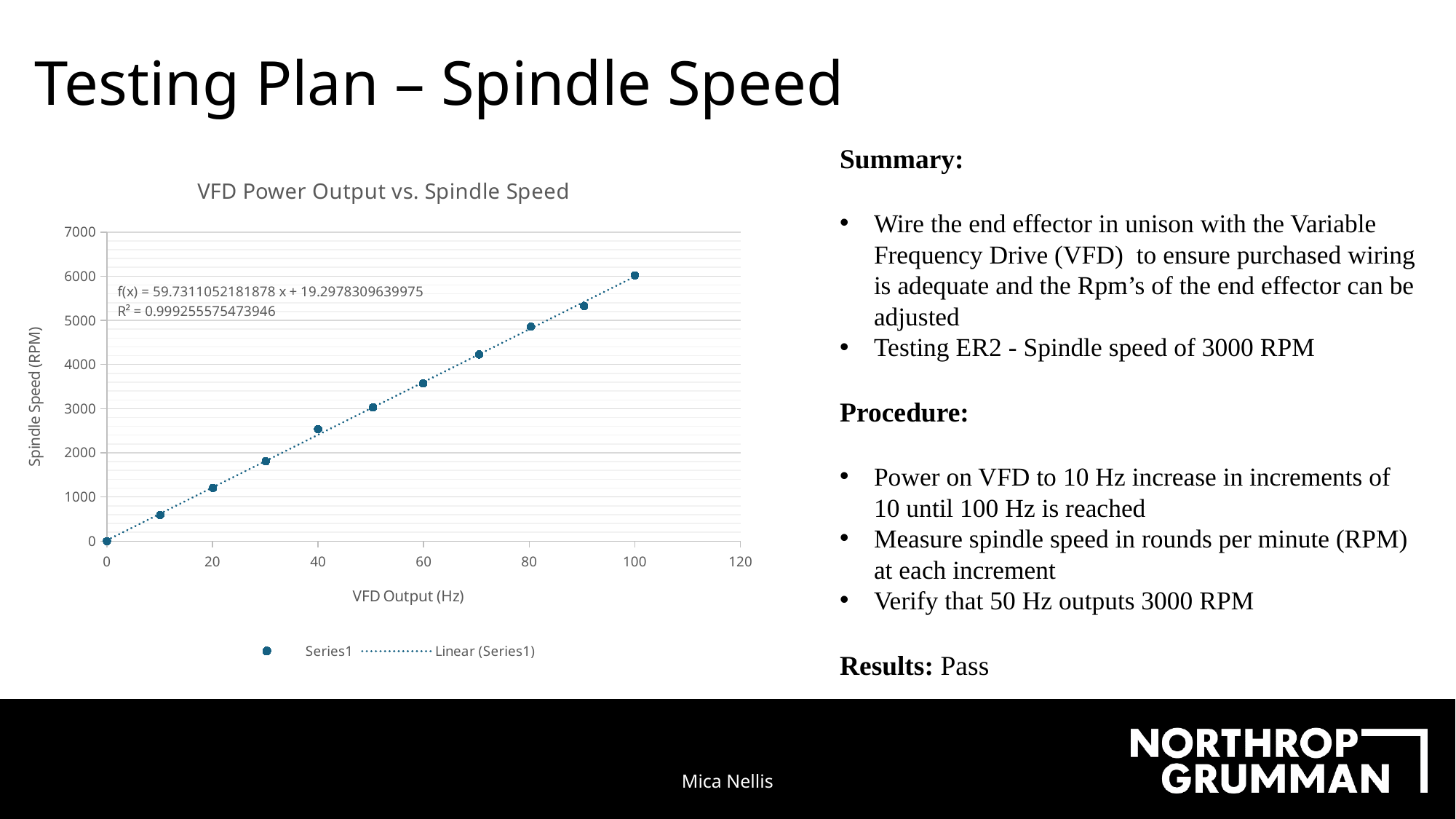
What R² value is printed on the chart for the linear fit? 0.999255575473946 How many entries does the chart legend list? 2 Which has a higher spindle speed: a VFD output of 60 Hz or 40 Hz? 60 Hz What is the title of the chart? VFD Power Output vs. Spindle Speed How many data points are plotted in the chart? 11 At which VFD output (Hz) is the spindle speed lowest? 0 Is the spindle speed at a VFD output of 100 Hz greater or less than 5000 RPM? greater Is the spindle speed at a VFD output of 20 Hz greater or less than 2000 RPM? less At which VFD output (Hz) is the spindle speed highest? 100 What is the spindle speed (RPM) at a VFD output of 0 Hz? 0 Does spindle speed rise or fall as VFD output increases along the x axis? Rises What kind of chart is shown on the slide? Scatter chart